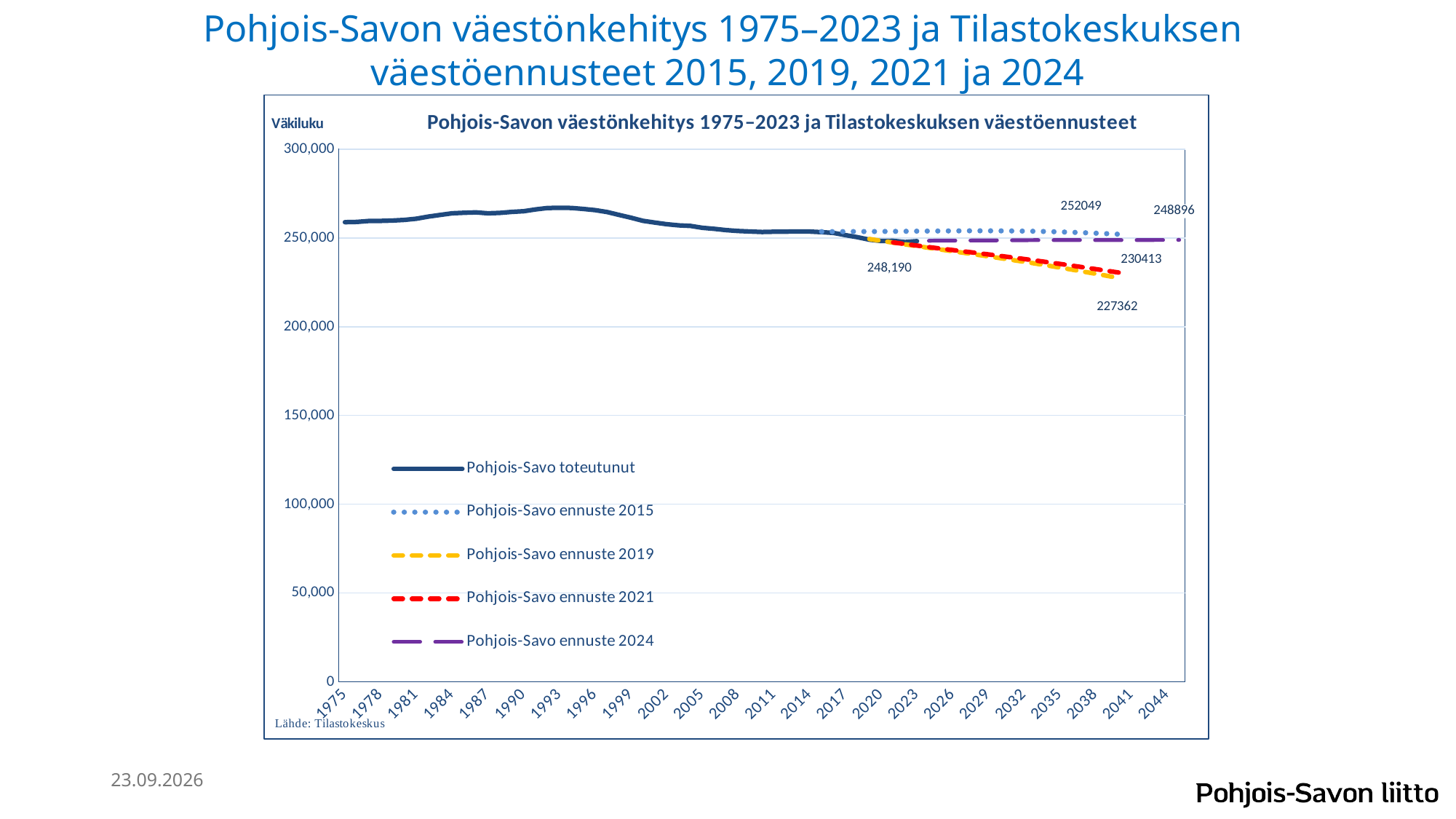
Which forecast series ends with the highest labelled value? Pohjois-Savo ennuste 2015 What is the difference between the final labelled values of the ennuste 2021 and ennuste 2019 series? 3051 What is the final labelled value of the Pohjois-Savo ennuste 2019 series? 227362 What is the final labelled value of the Pohjois-Savo ennuste 2024 series? 248896 What is the final labelled value of the Pohjois-Savo ennuste 2021 series? 230413 Is the final labelled value of the ennuste 2015 series larger or smaller than that of the ennuste 2024 series? larger Which forecast series ends with the lowest labelled value? Pohjois-Savo ennuste 2019 How many series does the legend list? 5 Is the value of the Pohjois-Savo toteutunut series in 1993 greater or less than 250,000? greater What is the labelled value at the end of the Pohjois-Savo toteutunut series? 248,190 What kind of chart is shown on the slide? line chart What is the final labelled value of the Pohjois-Savo ennuste 2015 series? 252049